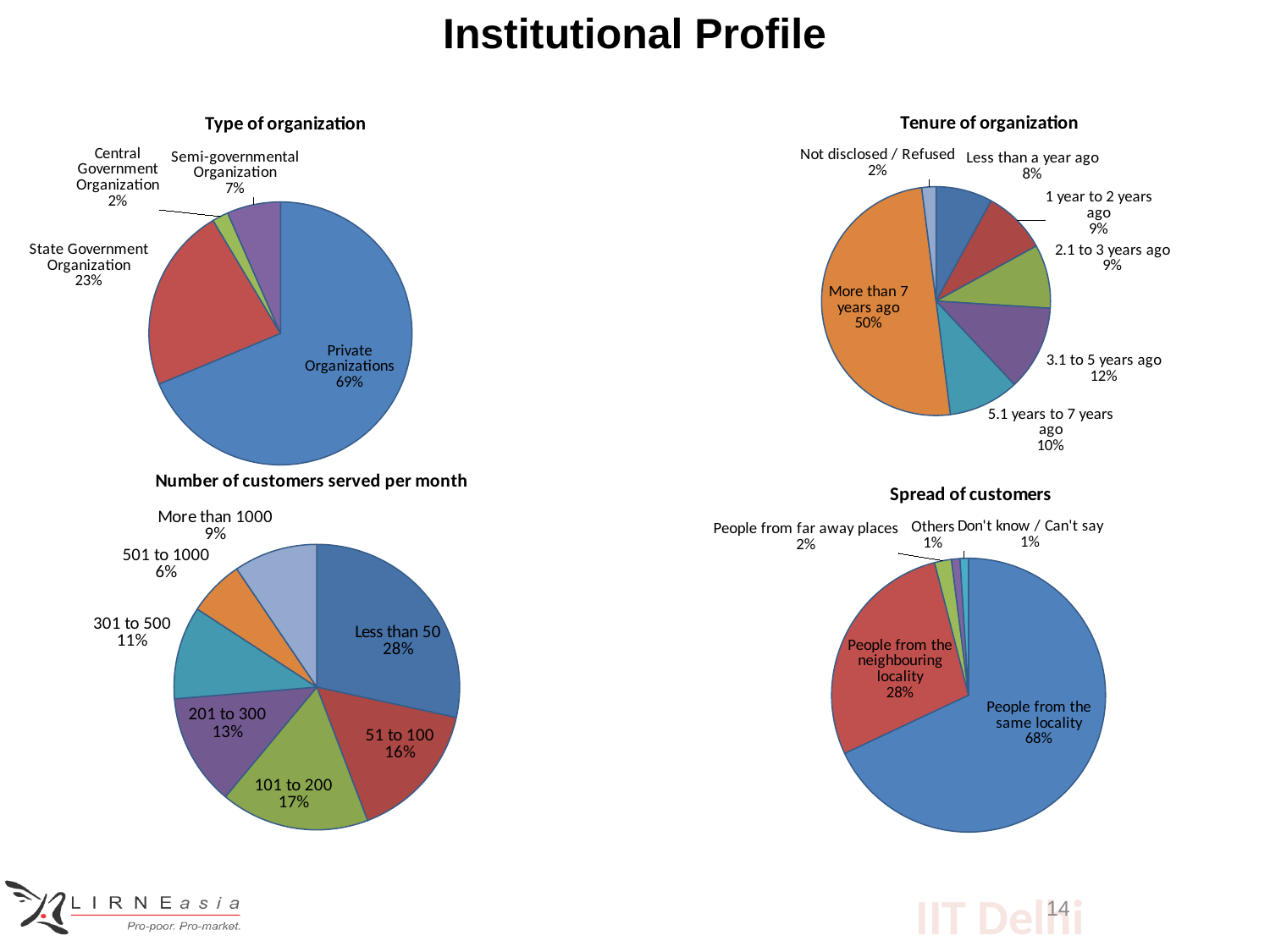
In the 'Spread of customers' chart, what share is 'People from the neighbouring locality'? 28% In the 'Spread of customers' chart, what is the difference between 'People from the same locality' and 'People from the neighbouring locality'? 40% In the 'Tenure of organization' chart, how many categories are shown? 7 In the 'Type of organization' chart, what share of the pie is Private Organizations? 69% In the 'Tenure of organization' chart, what is the value for 'More than 7 years ago'? 50% In the 'Number of customers served per month' chart, what is the value for '201 to 300'? 13% In the 'Number of customers served per month' chart, which category has the largest share? Less than 50 In the 'Type of organization' chart, which category has the smallest share? Central Government Organization What type of chart is the 'Spread of customers' chart? Pie chart How many charts are shown on the slide? 4 In the 'Number of customers served per month' chart, which is larger: '101 to 200' or '51 to 100'? 101 to 200 In the 'Tenure of organization' chart, what is the difference between '3.1 to 5 years ago' and 'Less than a year ago'? 4%